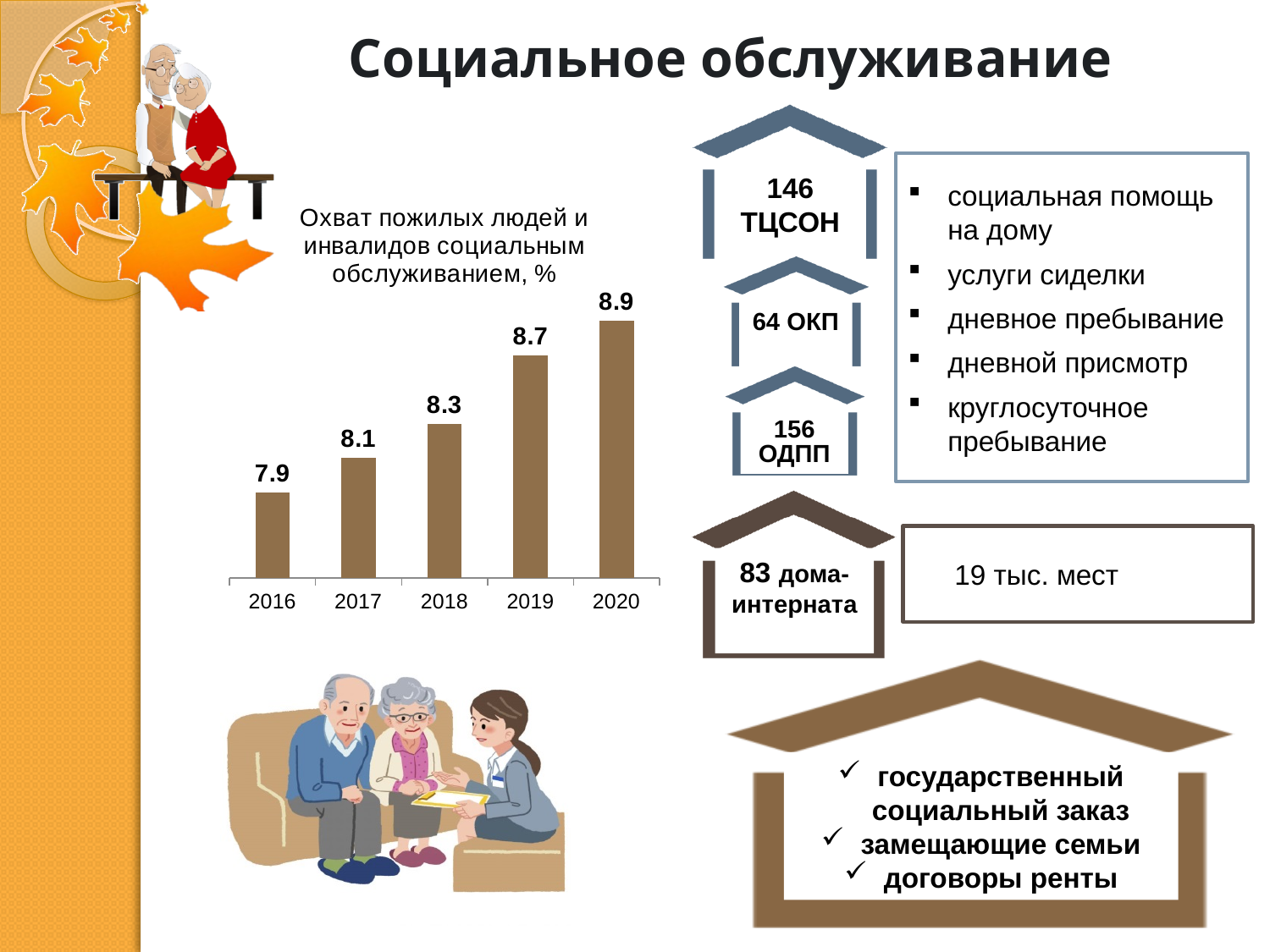
Which year has the lowest value in the chart? 2016 What is the title of the chart? Охват пожилых людей и инвалидов социальным обслуживанием, % What is the value for 2018 in the chart? 8.3 What is the value for 2016 in the chart? 7.9 Which year has the highest value in the chart? 2020 What is the difference between the values for 2019 and 2018? 0.4 What is the difference between the values for 2020 and 2016? 1.0 Which is larger, the value for 2017 or the value for 2019? 2019 How many years are shown on the x axis of the chart? 5 What is the value for 2020 in the chart? 8.9 Do the values rise or fall from 2016 to 2020? rise What kind of chart is shown on the slide? bar chart